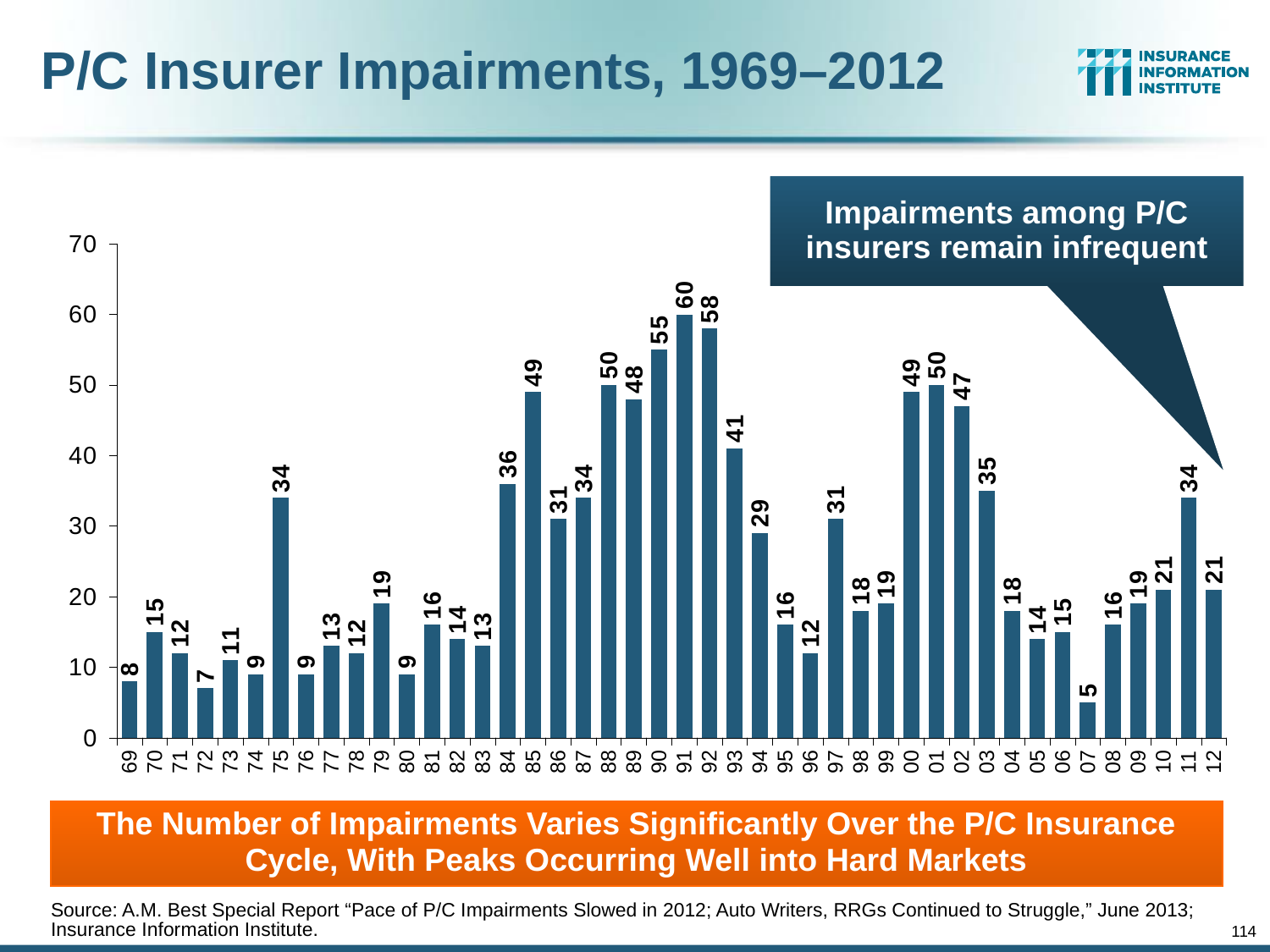
How many P/C insurer impairments were there in 1991? 60 Which year has the highest number of impairments? 1991 Which year had more impairments, 1985 or 2002? 1985 Is the value for 1993 greater or less than 40? greater What is the title of the slide's chart? P/C Insurer Impairments, 1969–2012 What is the difference between the impairments in 1991 and 2007? 55 Which year has the lowest number of impairments? 2007 How many years (bars) are plotted on the chart? 44 What kind of chart is shown on the slide? Bar chart How many impairments are shown for 1975? 34 How many more impairments were there in 2001 than in 2000? 1 What is the value shown for 2012? 21